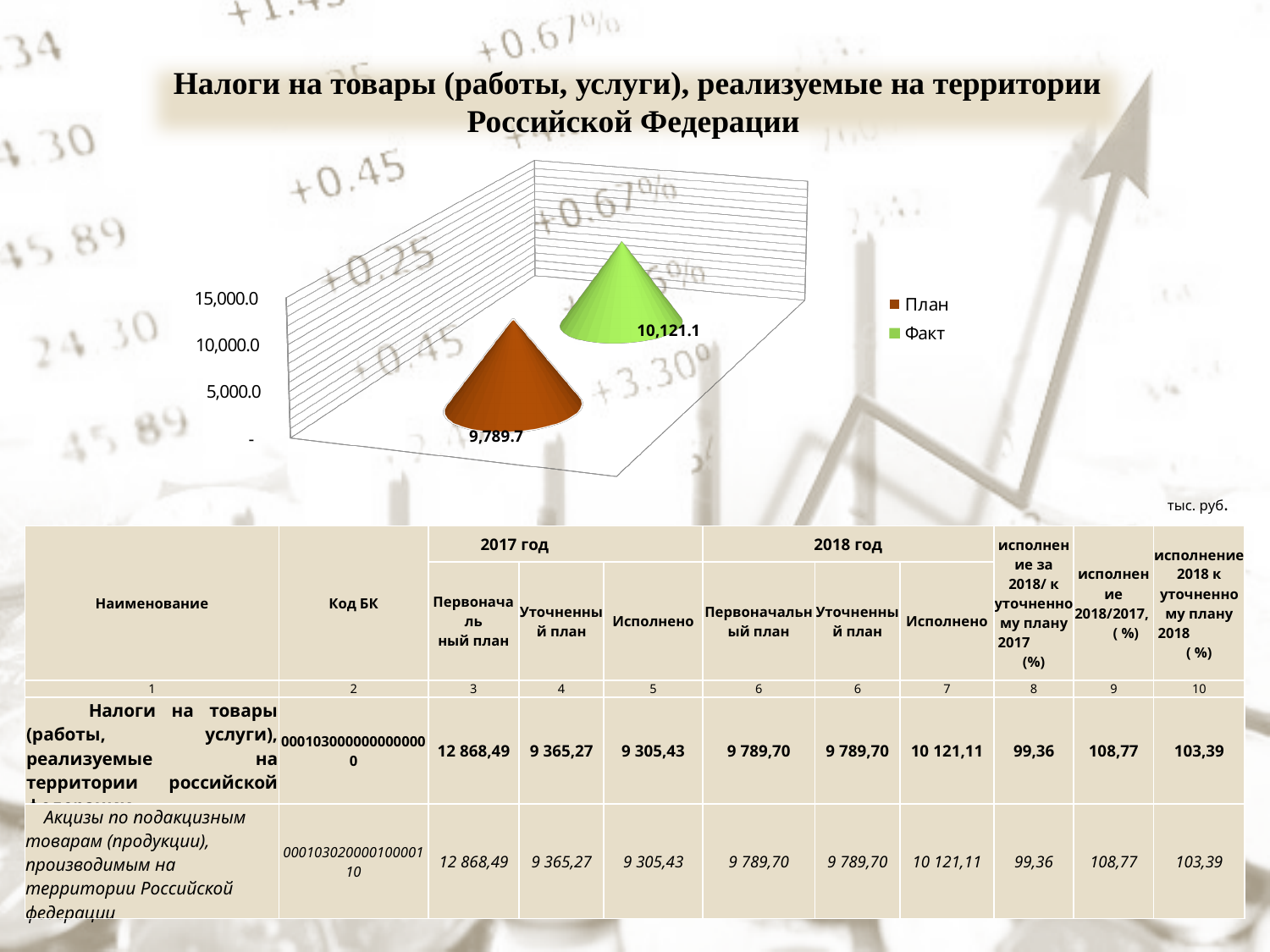
Which series has the higher value on the chart, План or Факт? Факт Is the value for Факт larger or smaller than the value for План? larger What are the two entries in the chart legend? План and Факт How many data points are plotted on the chart? 2 What is the value shown for План (Plan) on the chart? 9,789.7 What kind of chart is shown on the slide? 3D cone chart Is the value for План greater or less than 10,000.0? less What is the difference between the Факт value and the План value on the chart? 331.4 How many series does the chart legend list? 2 Which series has the lower value on the chart? План Is the value for Факт greater or less than 10,000.0? greater What is the value shown for Факт (Fact) on the chart? 10,121.1